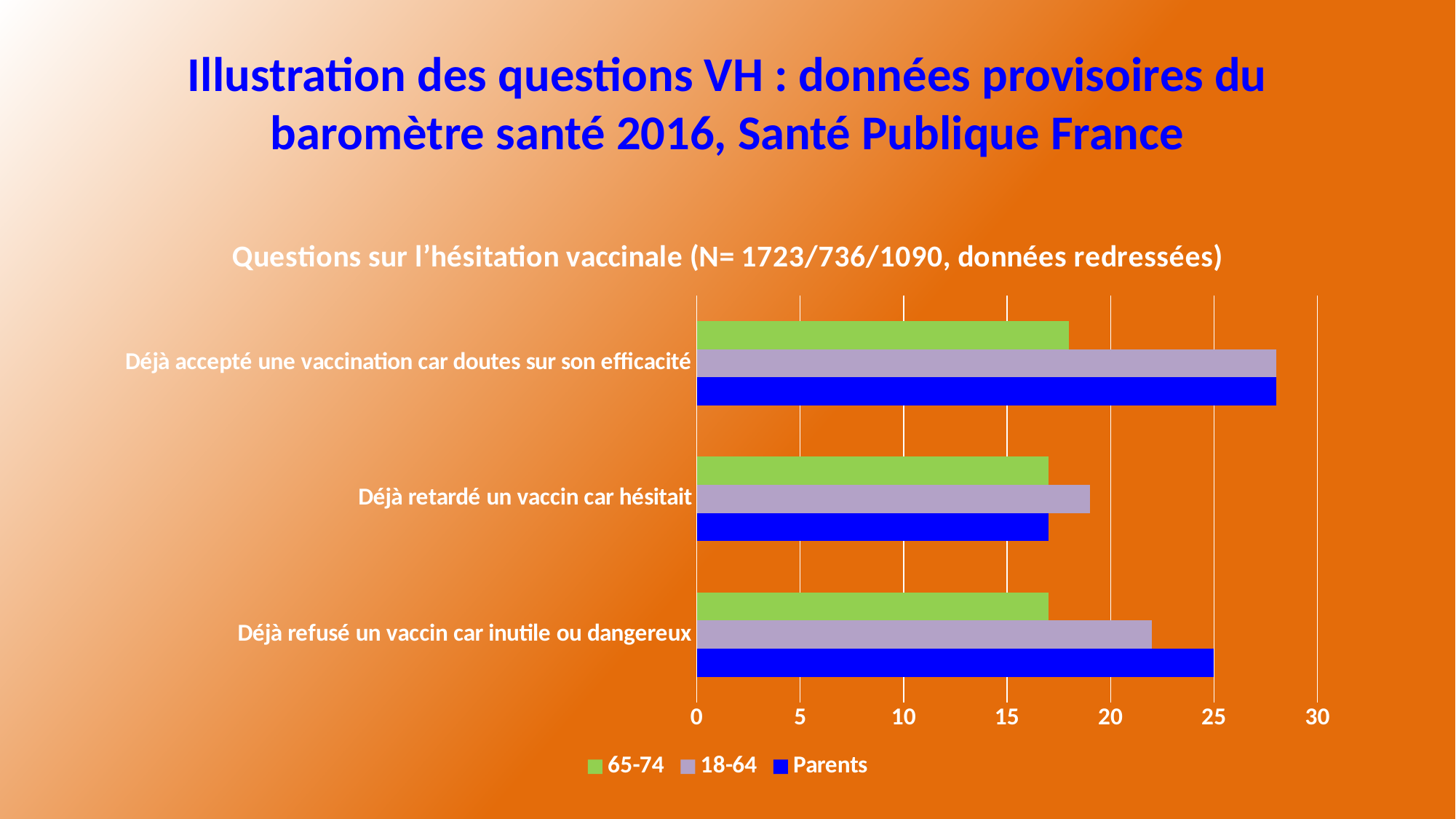
Is the value for 18-64 in 'Déjà refusé un vaccin car inutile ou dangereux' greater or less than 20? greater For the Parents series, which category has the highest value? Déjà accepté une vaccination car doutes sur son efficacité Is the value for 65-74 in 'Déjà accepté une vaccination car doutes sur son efficacité' greater or less than 20? less Is the value for Parents in 'Déjà retardé un vaccin car hésitait' greater or less than 15? greater Which series are listed in the legend? 65-74, 18-64, Parents How many categories are plotted on the chart? 3 How many series does the legend list? 3 For the Parents series, which category has the lowest value? Déjà retardé un vaccin car hésitait What kind of chart is shown on the slide? bar chart For 'Déjà refusé un vaccin car inutile ou dangereux', which is larger: the Parents value or the 65-74 value? Parents